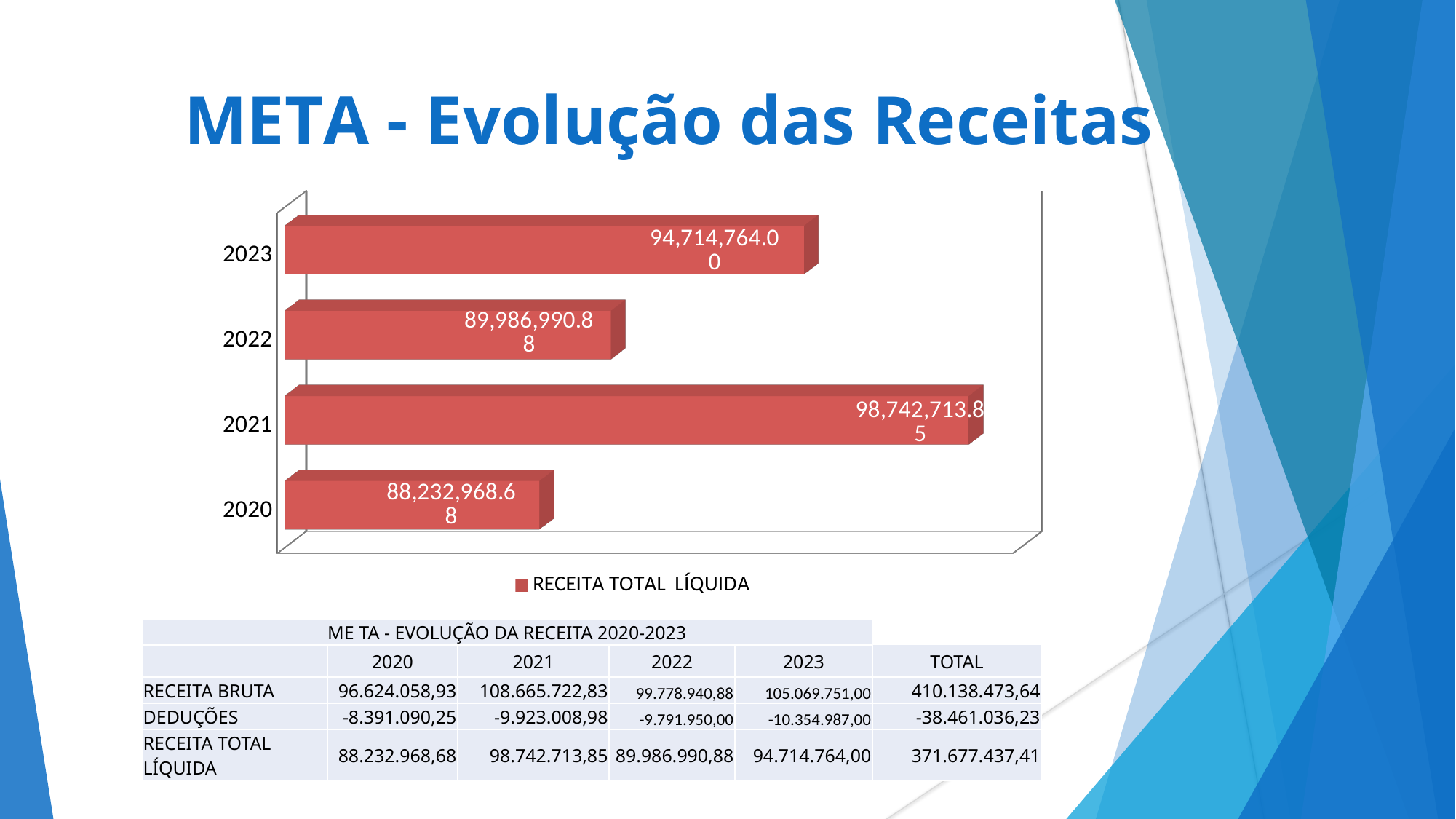
Which year has the highest value in the chart? 2021 How many years are shown in the chart? 4 What is the value for 2022 in the chart? 89,986,990.88 What kind of chart is shown on the slide? Bar chart What is the value for 2020 in the chart? 88,232,968.68 Which is larger, the value for 2023 or the value for 2022? 2023 What is the value for 2023 in the chart? 94,714,764.00 What is the difference between the values for 2023 and 2022? 4,727,773.12 What series name does the chart legend show? RECEITA TOTAL LÍQUIDA Which year has the lowest value in the chart? 2020 What is the value for 2021 in the chart? 98,742,713.85 What is the difference between the values for 2021 and 2020? 10,509,745.17